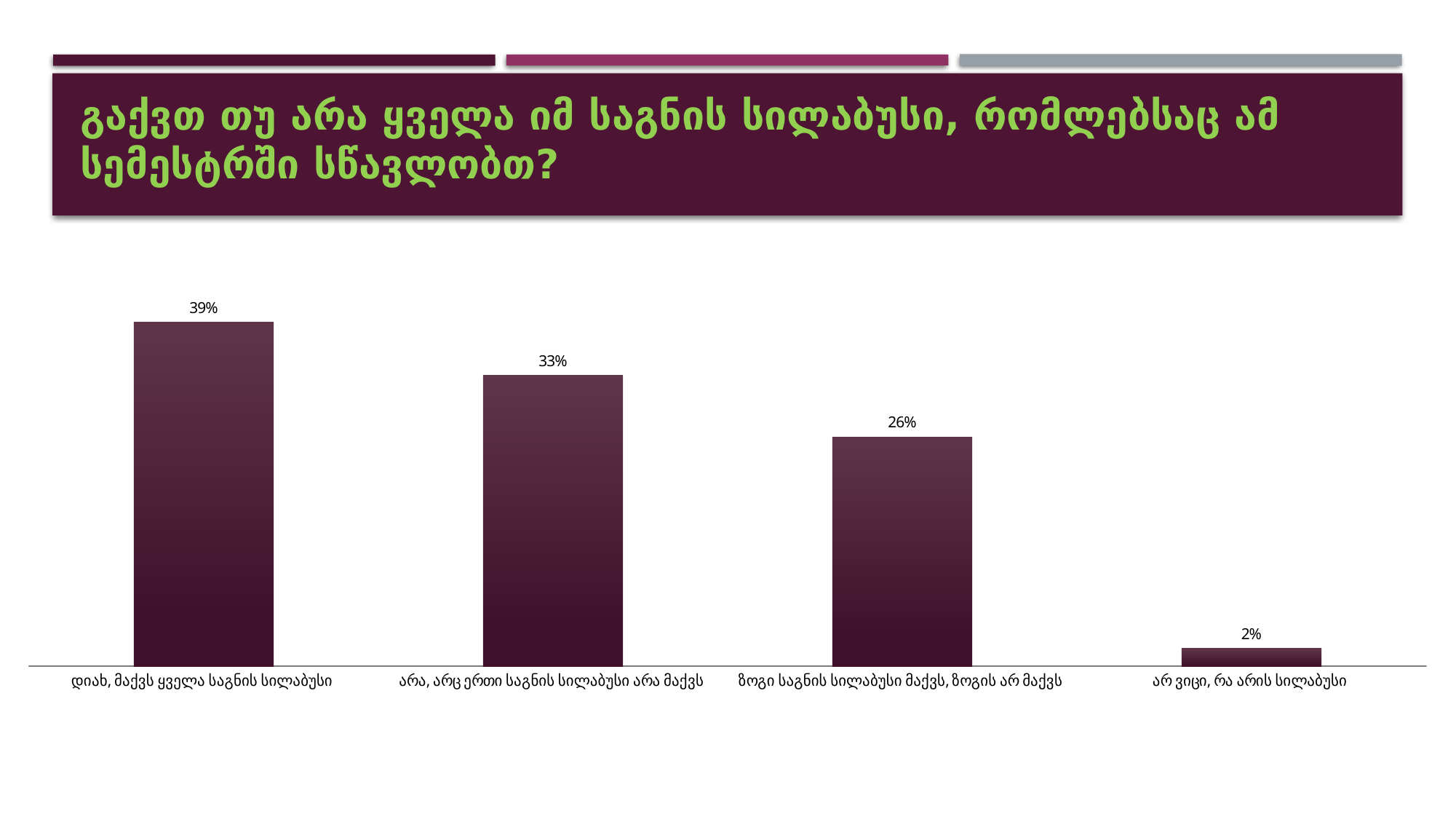
Which category has the highest value? დიახ, მაქვს ყველა საგნის სილაბუსი Do the values rise or fall from left to right across the categories? Fall What value is shown for the category "არა, არც ერთი საგნის სილაბუსი არა მაქვს"? 33% Which category has the lowest value? არ ვიცი, რა არის სილაბუსი What kind of chart is shown on the slide? Bar chart What is the difference between the values for "დიახ, მაქვს ყველა საგნის სილაბუსი" and "არა, არც ერთი საგნის სილაბუსი არა მაქვს"? 6% What value is shown for the category "დიახ, მაქვს ყველა საგნის სილაბუსი"? 39% How many categories are shown in the chart? 4 What is the difference between the values for "ზოგი საგნის სილაბუსი მაქვს, ზოგის არ მაქვს" and "არ ვიცი, რა არის სილაბუსი"? 24% What value is shown for the category "არ ვიცი, რა არის სილაბუსი"? 2% Which is larger: the value for "არა, არც ერთი საგნის სილაბუსი არა მაქვს" or the value for "ზოგი საგნის სილაბუსი მაქვს, ზოგის არ მაქვს"? არა, არც ერთი საგნის სილაბუსი არა მაქვს What value is shown for the category "ზოგი საგნის სილაბუსი მაქვს, ზოგის არ მაქვს"? 26%